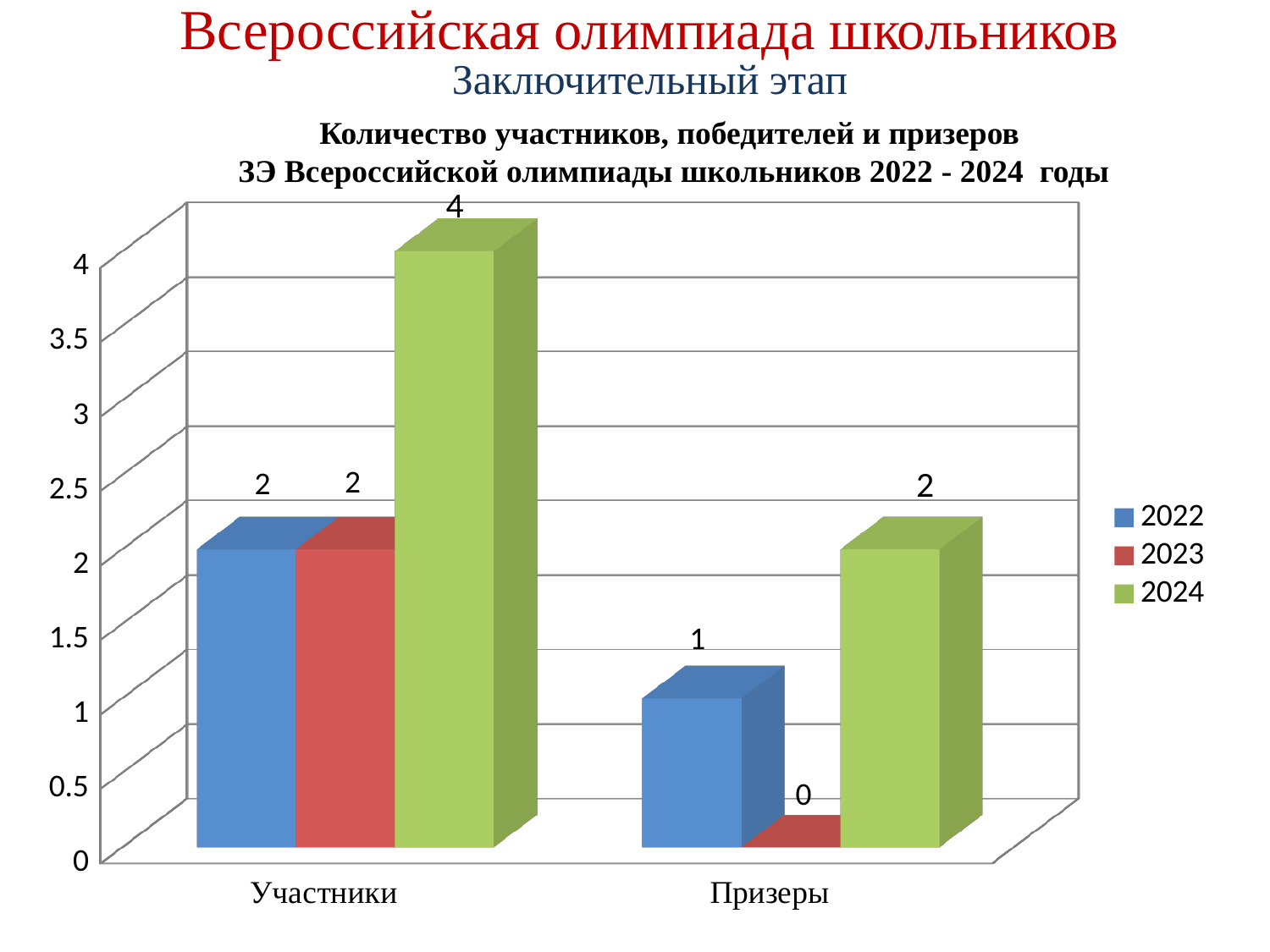
Which year has the lowest value in the Призеры category? 2023 What is the value for 2023 in the Участники category? 2 What is the value for 2022 in the Призеры category? 1 What is the value for 2024 in the Участники category? 4 Which colour represents the 2023 series in the legend? red What is the difference between the 2024 and 2022 values in the Участники category? 2 How many categories are shown on the x axis? 2 What kind of chart is shown on the slide? bar chart Which year has the highest value in the Участники category? 2024 Which is larger: the 2024 value for Призеры or the 2022 value for Призеры? 2024 What is the value for 2023 in the Призеры category? 0 How many series does the legend list? 3